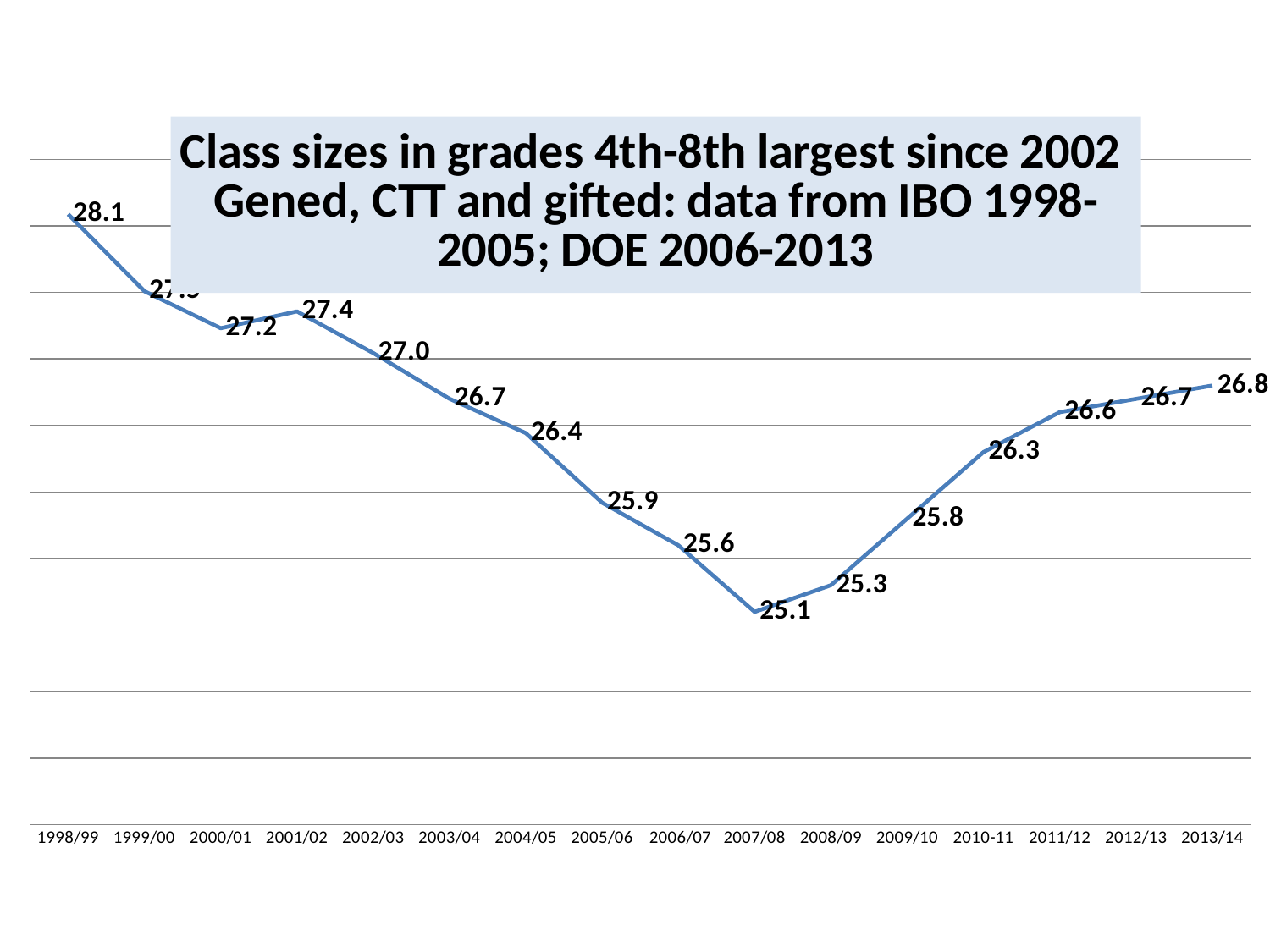
What type of chart is shown on the slide? line chart Do class sizes rise or fall from 2007/08 to 2013/14? rise Which school year has the lowest class size? 2007/08 What was the class size in 1998/99? 28.1 What is the difference between the class size in 1998/99 and in 2007/08? 3.0 What was the class size in 2007/08? 25.1 What is the difference between the class size in 2013/14 and in 2008/09? 1.5 Which is larger, the class size in 2001/02 or in 2013/14? 2001/02 What was the class size in 2003/04? 26.7 Which school year has the highest class size? 1998/99 How many school years are plotted on the x axis? 16 What was the class size in 2013/14? 26.8